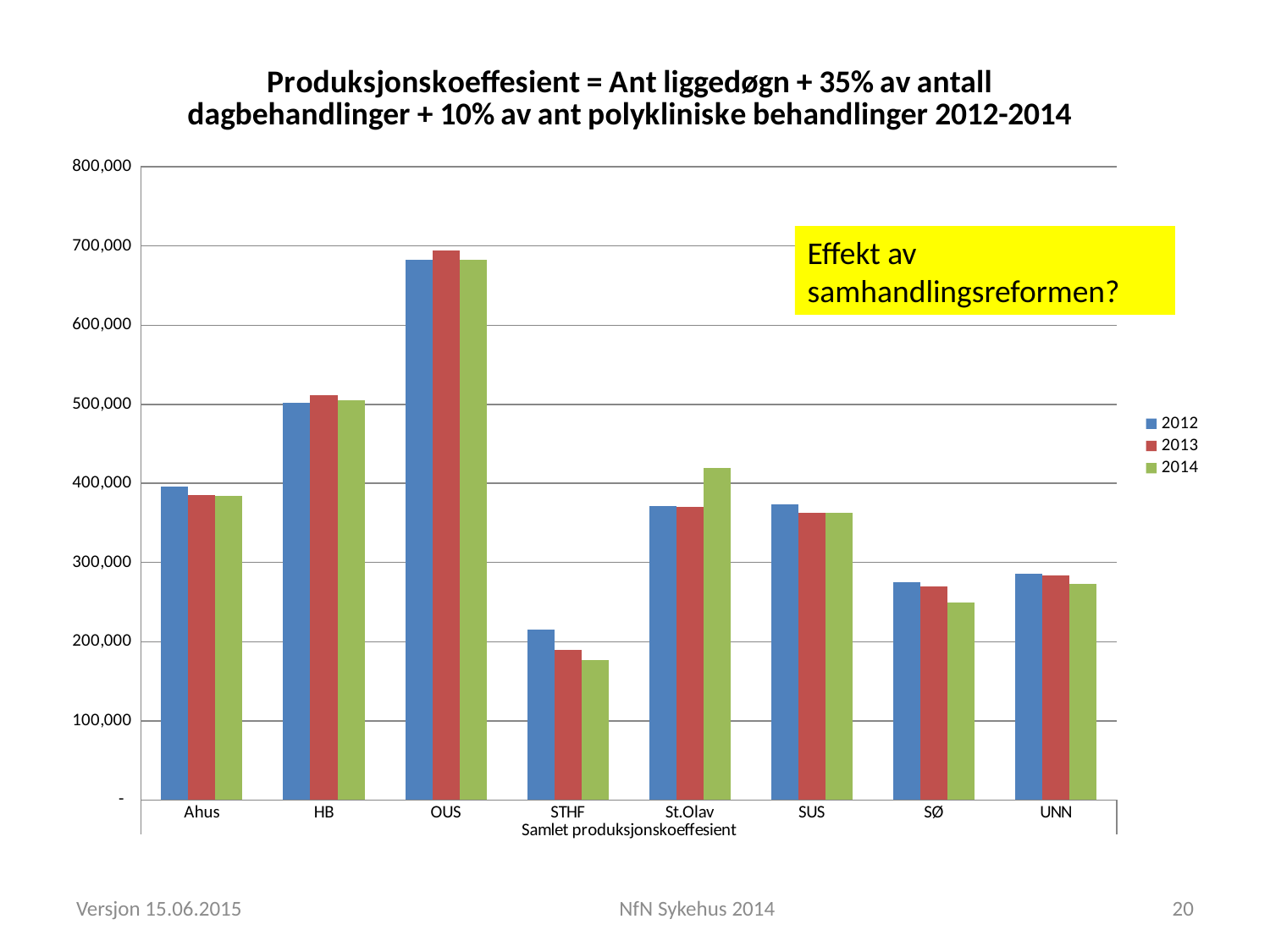
How many series does the legend list? 3 Is the value for STHF in 2014 greater or less than 200,000? less What kind of chart is shown on the slide? bar chart Do the values for STHF rise or fall from 2012 to 2014? fall Which hospital has the highest production coefficient in 2013? OUS How many hospitals (categories) are shown on the x axis? 8 Is the value for SØ in 2014 greater or less than 300,000? less Is the value for OUS in 2012 greater or less than 600,000? greater Which colour represents the 2014 series in the legend? green Which hospital has the lowest production coefficient in 2014? STHF Which is larger in 2014: the value for St.Olav or the value for SUS? St.Olav